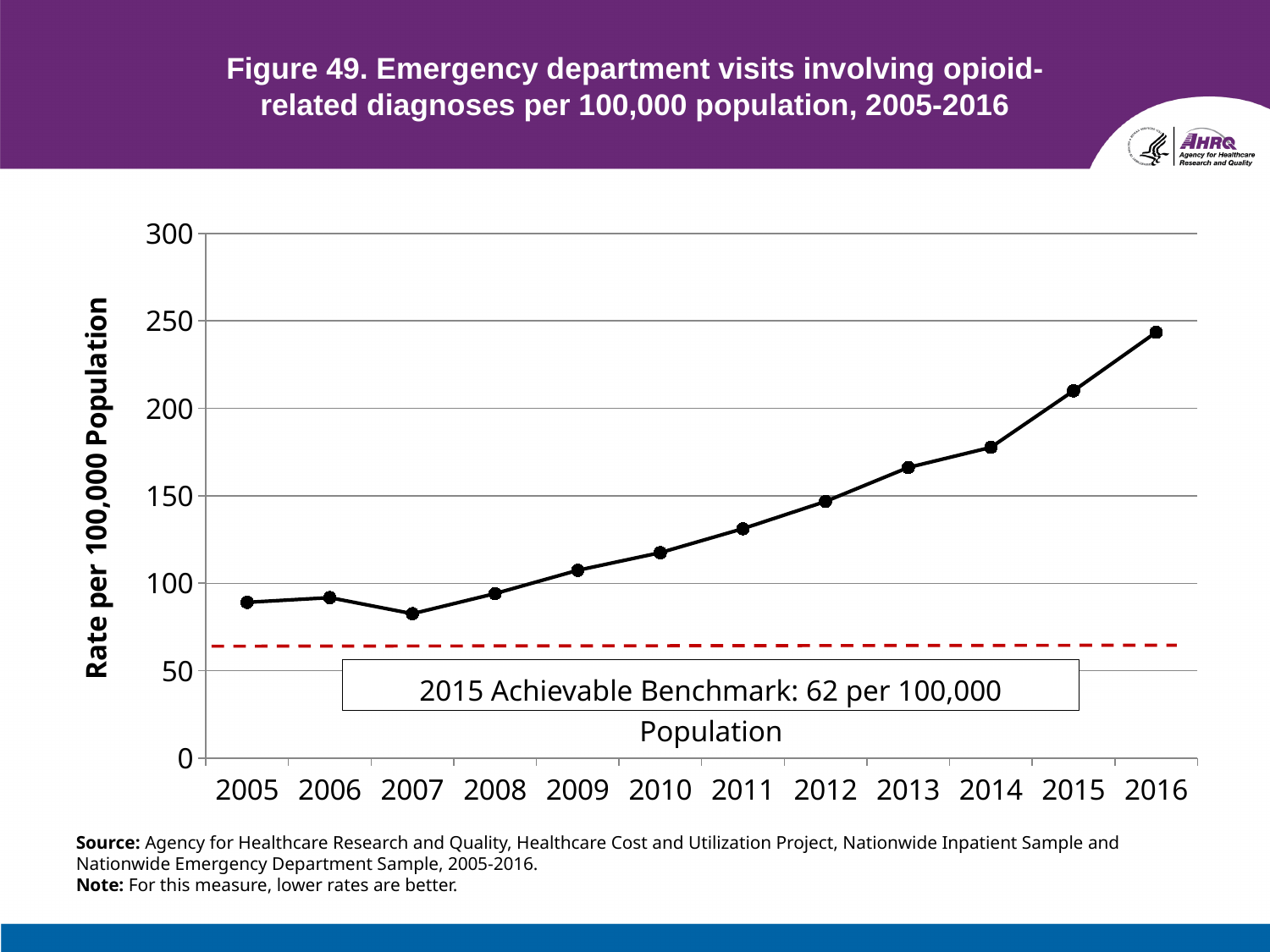
Do the rates generally rise or fall from 2007 to 2016? rise Which year has the highest rate of emergency department visits involving opioid-related diagnoses? 2016 How many years are plotted on the x axis? 12 What kind of chart is shown on the slide? line chart Which year has the lowest rate of emergency department visits involving opioid-related diagnoses? 2007 Is the value for 2005 greater or less than 100? less Is the value for 2016 greater or less than 200? greater Which year has a higher rate, 2010 or 2015? 2015 What is the label on the y axis? Rate per 100,000 Population What is the 2015 achievable benchmark shown on the chart? 62 per 100,000 Population Is the value for 2014 greater or less than 200? less